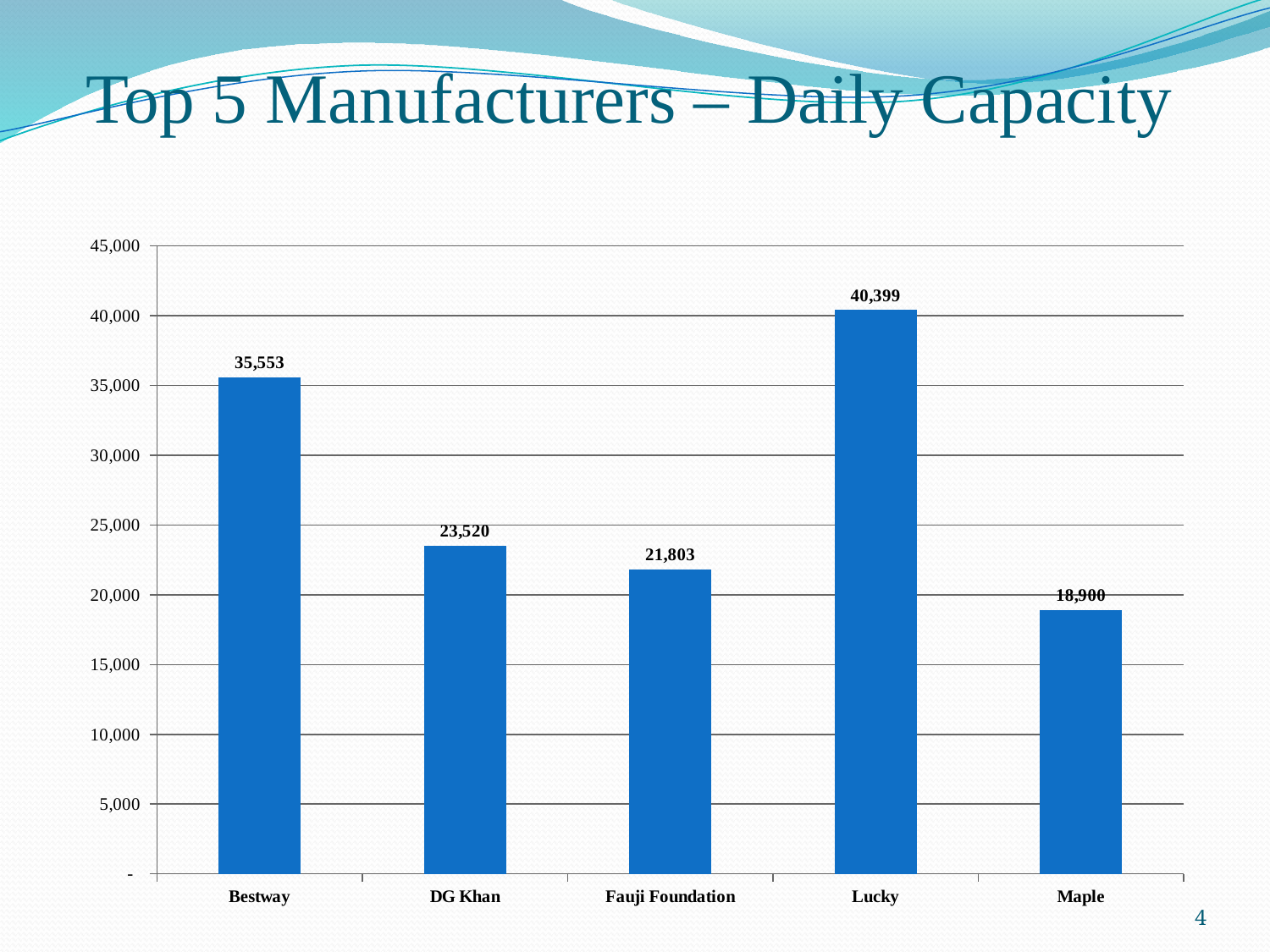
Which manufacturer has the highest daily capacity? Lucky What is the daily capacity value shown for Fauji Foundation? 21,803 What is the difference between the daily capacity of DG Khan and Fauji Foundation? 1,717 Which has a larger daily capacity, DG Khan or Maple? DG Khan What is the daily capacity value shown for Maple? 18,900 What kind of chart is shown on the slide? Bar chart What is the daily capacity value shown for Lucky? 40,399 Which manufacturer has the lowest daily capacity? Maple Is the value for Fauji Foundation greater or less than 25,000? less How many manufacturers are shown in the chart? 5 What is the daily capacity value shown for Bestway? 35,553 What is the difference between the daily capacity of Lucky and Bestway? 4,846